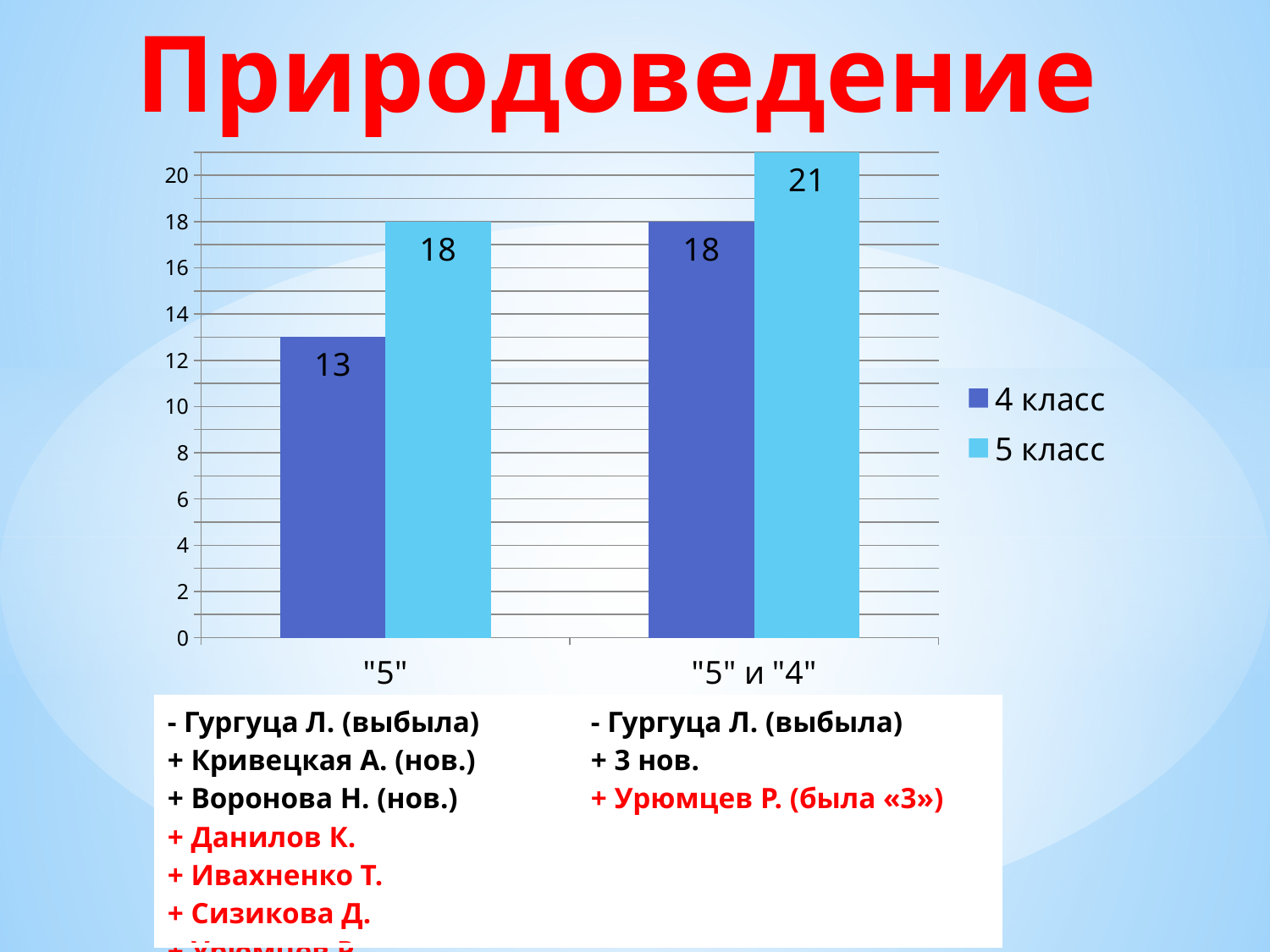
What is the difference between the "5 класс" and "4 класс" values in the "5" и "4" category? 3 Which series has the higher value in the "5" category? 5 класс What kind of chart is shown on the slide? bar chart What is the value for "4 класс" in the "5" category? 13 How many series does the legend list? 2 Which bar has the lowest value on the chart? 4 класс in "5" (13) What is the value for "4 класс" in the "5" и "4" category? 18 What is the value for "5 класс" in the "5" category? 18 What is the difference between the "5 класс" and "4 класс" values in the "5" category? 5 How many categories are shown on the x axis? 2 What is the value for "5 класс" in the "5" и "4" category? 21 Which bar has the highest value on the chart? 5 класс in "5" и "4" (21)